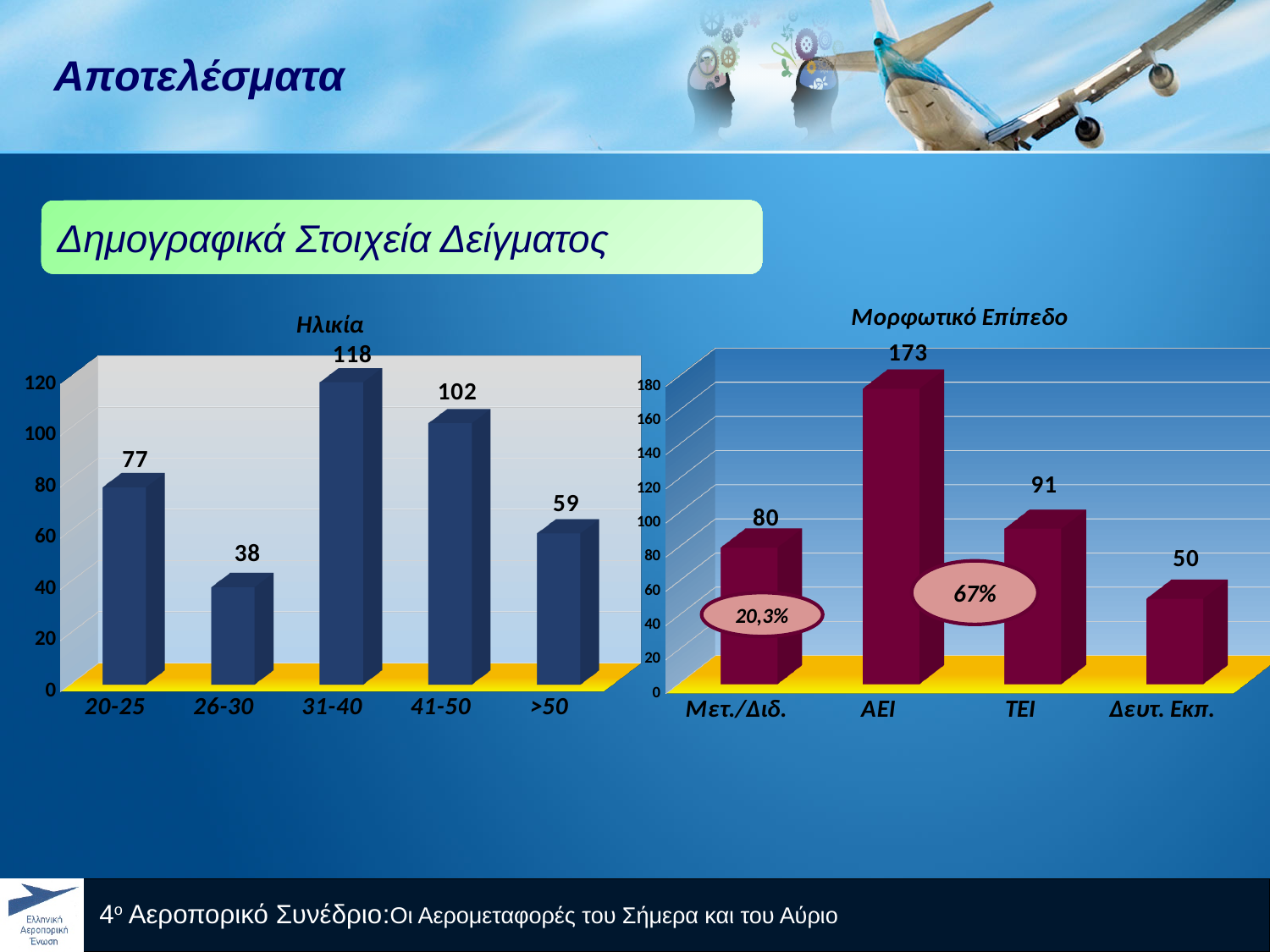
In the Ηλικία chart, is the value for 20-25 larger than the value for >50? Yes In the Ηλικία chart, what is the difference between the values for 41-50 and >50? 43 In the Μορφωτικό Επίπεδο chart, what is the value for ΑΕΙ? 173 In the Ηλικία chart, what is the value for the 31-40 category? 118 In the Ηλικία chart, how many age categories are shown? 5 What kind of chart is the Μορφωτικό Επίπεδο chart? Bar chart In the Ηλικία chart, which age category has the highest value? 31-40 In the Μορφωτικό Επίπεδο chart, what is the difference between the values for ΑΕΙ and ΤΕΙ? 82 In the Μορφωτικό Επίπεδο chart, how many categories are shown? 4 In the Μορφωτικό Επίπεδο chart, what percentage is shown in the oval label near the ΤΕΙ bar? 67% In the Μορφωτικό Επίπεδο chart, which category has the lowest value? Δευτ. Εκπ. In the Ηλικία chart, which age category has the lowest value? 26-30